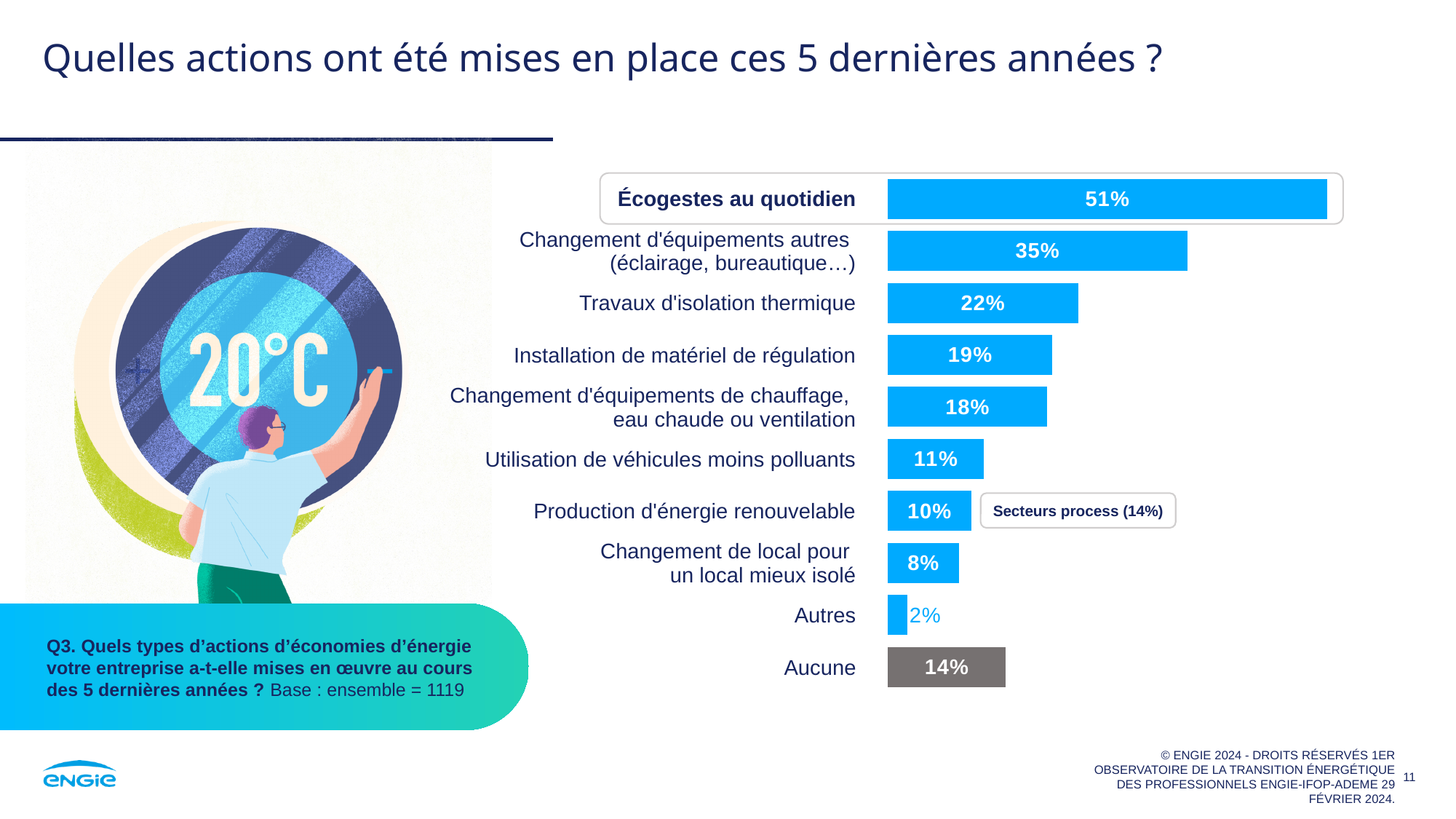
Which is larger: "Installation de matériel de régulation" or "Changement d'équipements de chauffage, eau chaude ou ventilation"? Installation de matériel de régulation What kind of chart is shown on the slide? Bar chart What percentage is shown for "Écogestes au quotidien"? 51% What percentage is shown for "Aucune"? 14% What is the value for "Travaux d'isolation thermique"? 22% Which category has the lowest percentage? Autres What is the difference between "Écogestes au quotidien" and "Changement d'équipements autres (éclairage, bureautique…)"? 16% How many categories are shown in the chart? 10 What is the value for "Production d'énergie renouvelable"? 10% Which bar is coloured grey instead of blue? Aucune Which action has the highest percentage? Écogestes au quotidien What percentage is given in the callout "Secteurs process" next to "Production d'énergie renouvelable"? 14%